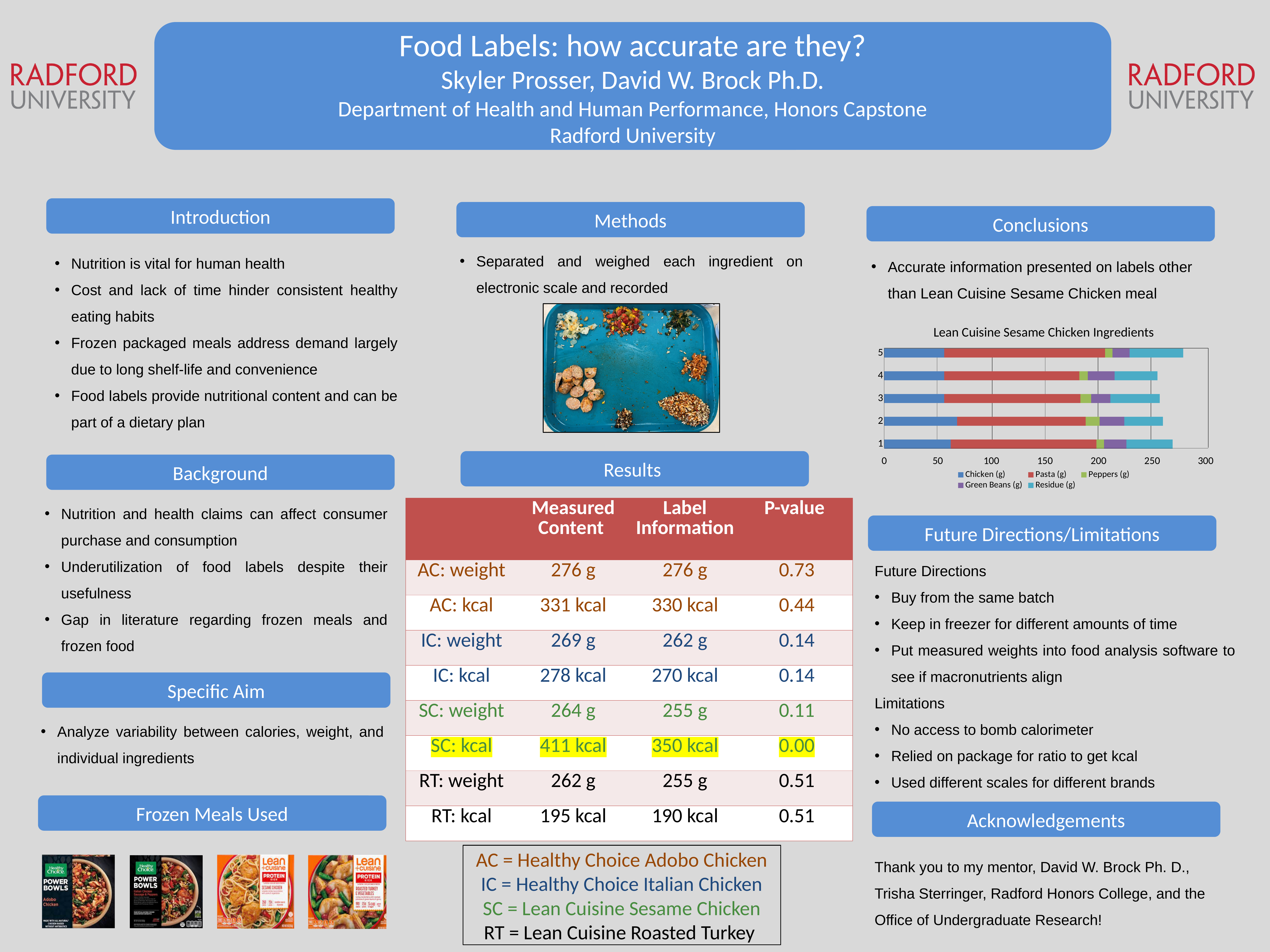
In the Lean Cuisine Sesame Chicken Ingredients chart, is the Pasta (g) segment of bar 1 greater or less than 100? greater In the Lean Cuisine Sesame Chicken Ingredients chart, is the total length of bar 5 greater or less than 250? greater What is the title of the chart on the slide? Lean Cuisine Sesame Chicken Ingredients In the Lean Cuisine Sesame Chicken Ingredients chart, is the Chicken (g) value for bar 2 greater or less than 50? greater How many bars (categories) are plotted in the Lean Cuisine Sesame Chicken Ingredients chart? 5 What kind of chart is shown under the Conclusions section? stacked bar chart How many series does the legend of the Lean Cuisine Sesame Chicken Ingredients chart list? 5 Which series is shown in red in the Lean Cuisine Sesame Chicken Ingredients chart? Pasta (g) In the Lean Cuisine Sesame Chicken Ingredients chart, is the Chicken (g) segment larger for bar 2 or bar 5? bar 2 In the Lean Cuisine Sesame Chicken Ingredients chart, which bar has the longest total length? 5